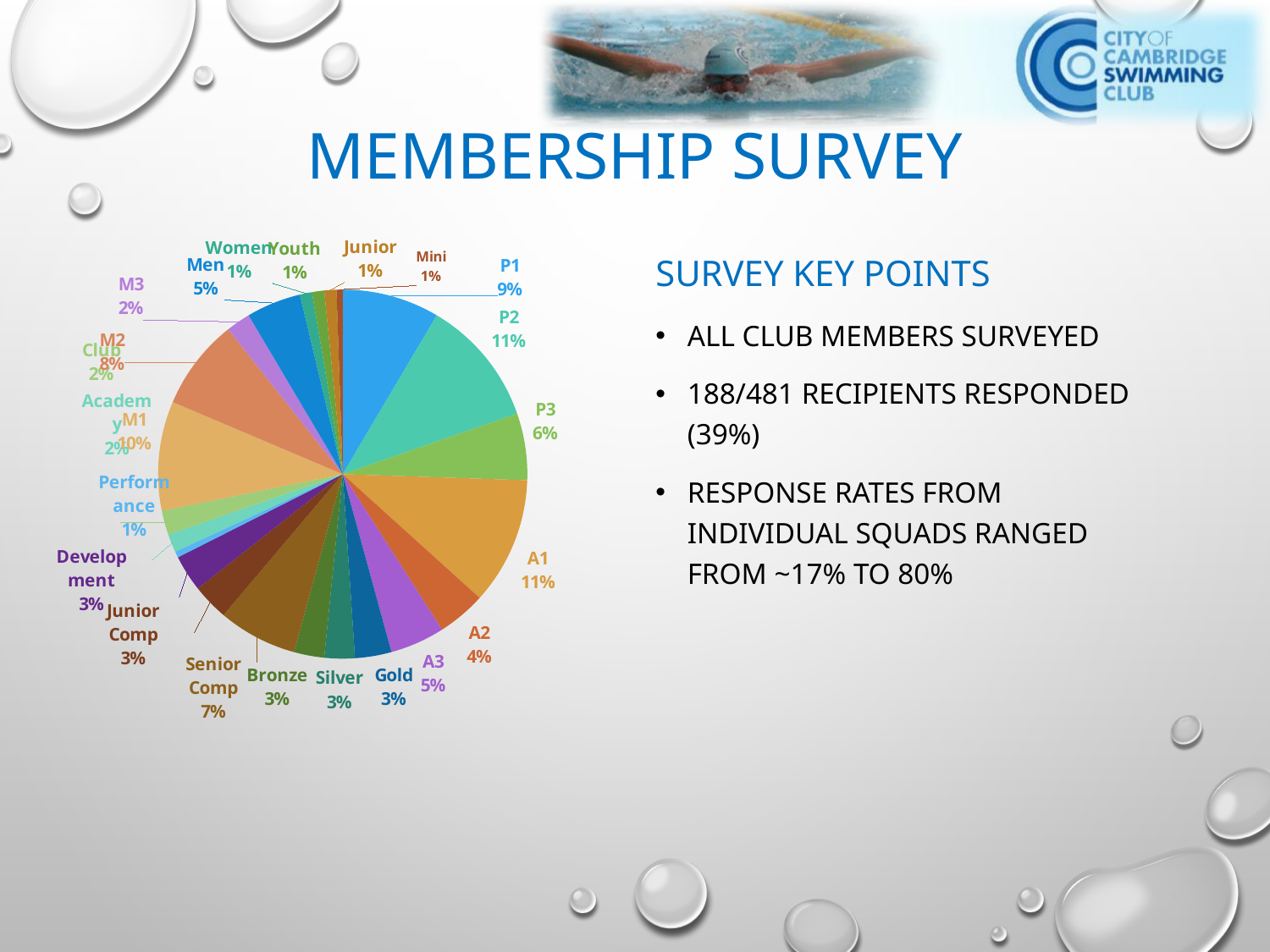
What is the value for Senior Comp? 7% What is the difference between the shares of P1 and A3? 4% What is the value for Development? 3% What share of the pie does P1 represent? 9% What percentage is shown for Men? 5% What percentage is shown for Gold? 3% Which is larger, A1 or A2? A1 Which is larger, P2 or P3? P2 What kind of chart is shown on the slide? Pie chart What percentage is shown for P3? 6% What is the title of the slide containing the chart? Membership Survey What share does A2 have in the pie chart? 4%